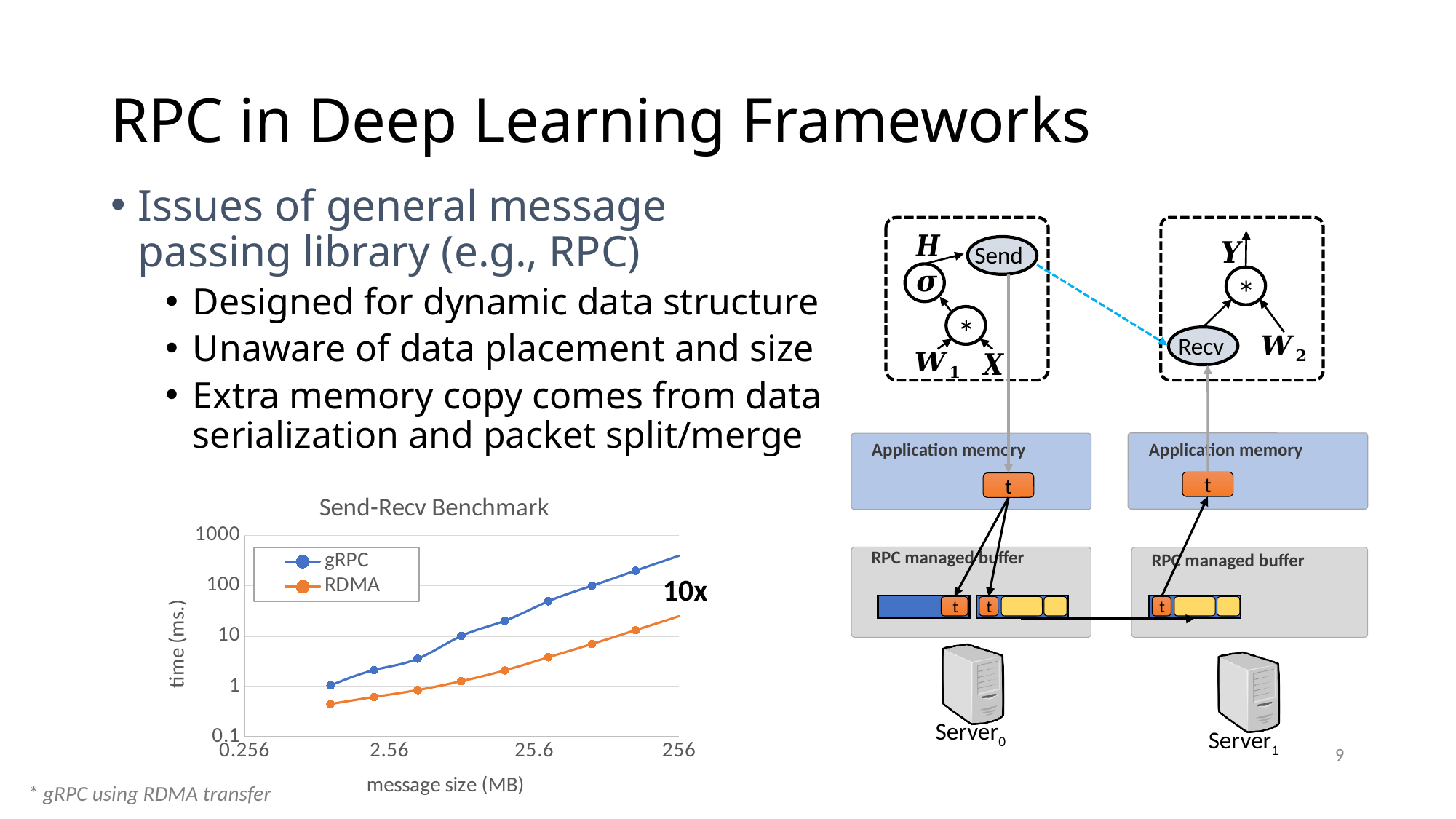
Which two series are shown in the Send-Recv Benchmark chart? gRPC and RDMA How many series does the legend of the Send-Recv Benchmark chart list? 2 In the Send-Recv Benchmark chart, is the gRPC time at a message size of 256 MB greater or less than 100 ms? greater In the Send-Recv Benchmark chart, does the time for gRPC rise or fall as message size increases? rise In the Send-Recv Benchmark chart, which series has the higher time at a message size of 25.6 MB, gRPC or RDMA? gRPC In the Send-Recv Benchmark chart, is the RDMA time at a message size of 25.6 MB greater or less than 10 ms? less What kind of chart is the Send-Recv Benchmark? line chart In the Send-Recv Benchmark chart, which series has the lower time across all message sizes? RDMA In the Send-Recv Benchmark chart, does the time for RDMA rise or fall as message size increases? rise What is the label of the y axis in the Send-Recv Benchmark chart? time (ms.) In the Send-Recv Benchmark chart, is the RDMA time at a message size of 2.56 MB greater or less than 1 ms? less